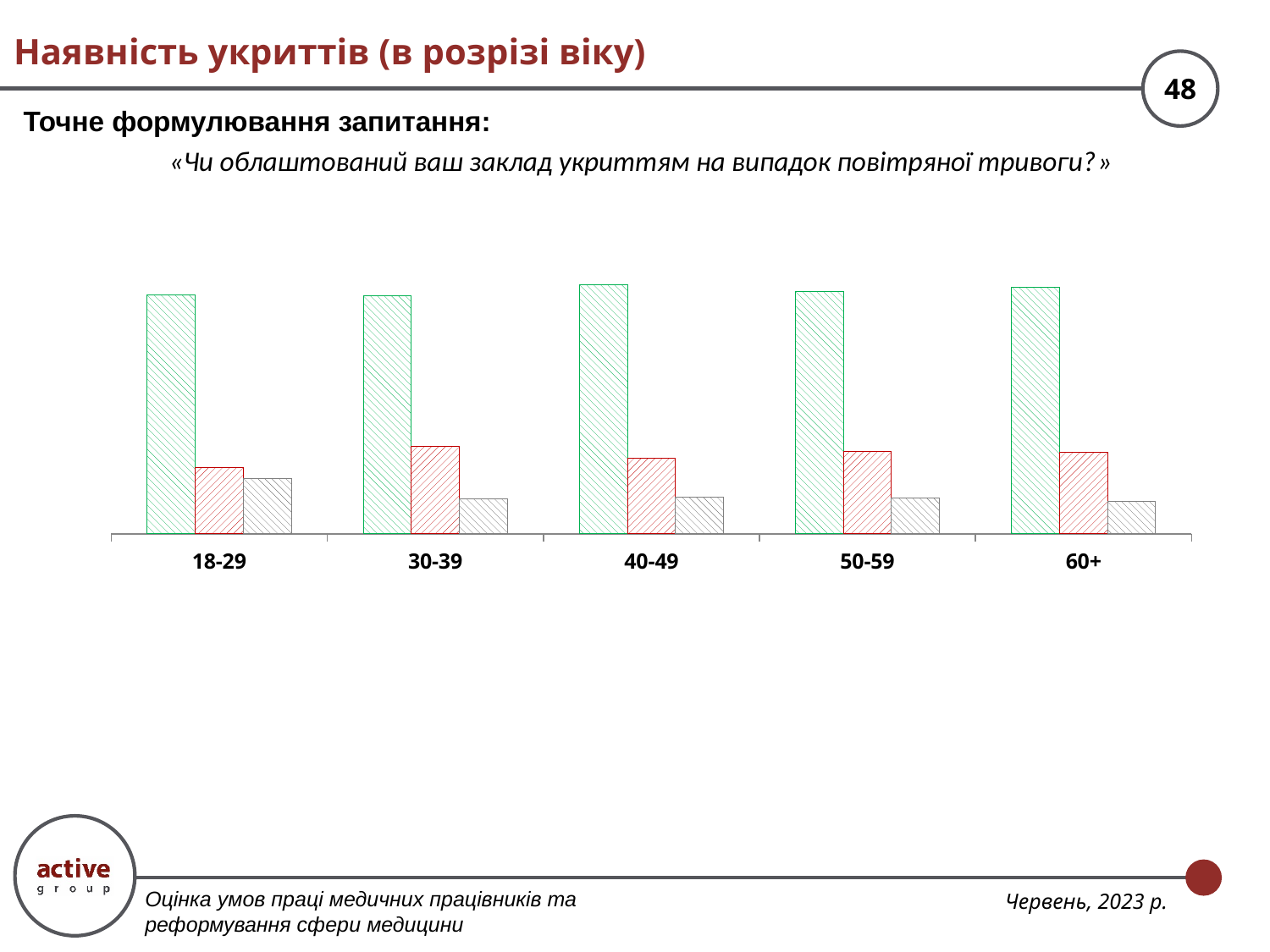
How many bars are plotted for each age group in the chart? 3 What kind of chart is shown on the slide? bar chart How many age groups are shown on the x axis of the chart? 5 In the 40-49 age group, which bar is the tallest? the green bar What is the label of the last age group on the x axis of the chart? 60+ Which age group has the lowest red bar in the chart? 18-29 In the 60+ age group, which bar is the shortest? the grey bar In the 30-39 age group, which bar is taller: the red bar or the grey bar? the red bar In the 18-29 age group, which bar is taller: the green bar or the red bar? the green bar Which age group has the highest grey bar in the chart? 18-29 What colours are the three bars in each age group of the chart? green, red and grey